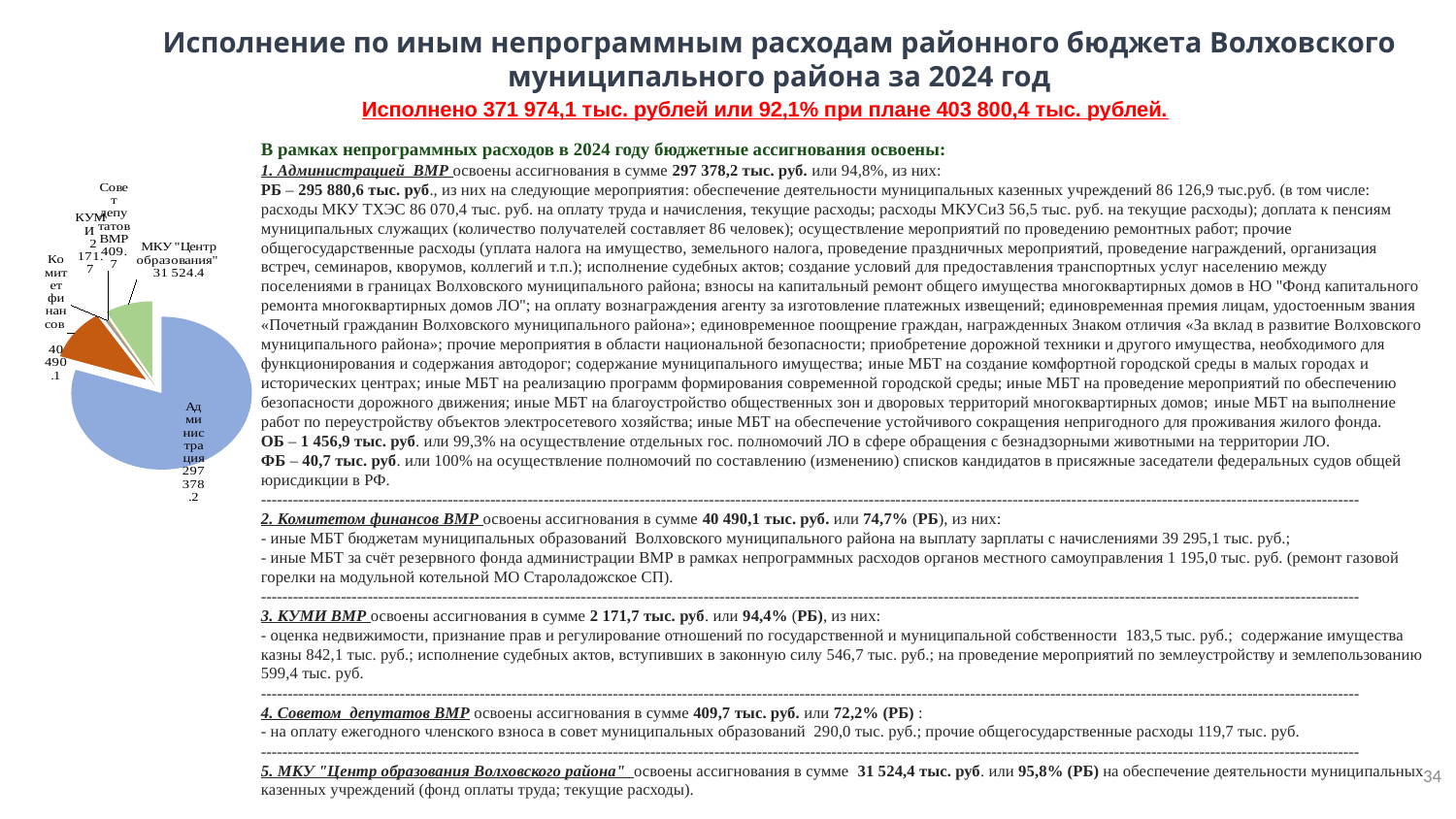
What value is shown for the Комитет финансов slice of the pie chart? 40 490.1 What is the difference between the Комитет финансов value and the МКУ "Центр образования" value in the pie chart? 8 965.7 What kind of chart is shown on the slide? pie chart Which slice of the pie chart is the largest? Администрация What value is shown for the Администрация slice of the pie chart? 297 378.2 What value is shown for the Совет депутатов slice of the pie chart? 409.7 What value is shown for the МКУ "Центр образования" slice of the pie chart? 31 524.4 How many slices does the pie chart have? 5 Which is larger in the pie chart: Комитет финансов or МКУ "Центр образования"? Комитет финансов What colour is the largest slice of the pie chart? blue Which slice of the pie chart is the smallest? Совет депутатов What value is shown for the КУМИ ВМР slice of the pie chart? 2 171.7